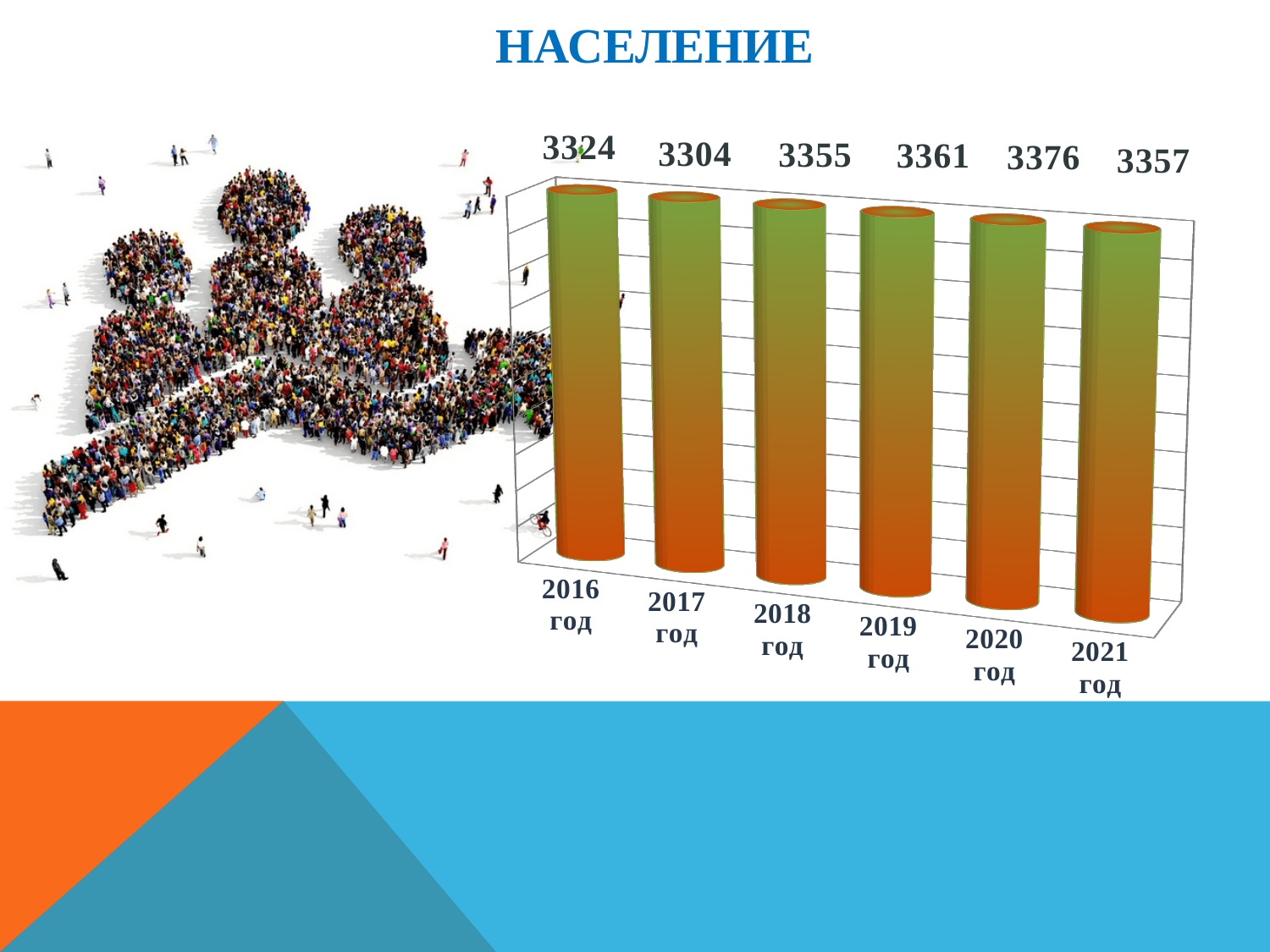
What is the difference between the population values for 2018 год and 2017 год? 51 What is the population value shown for 2021 год? 3357 What is the population value shown for 2019 год? 3361 How many years are shown on the chart? 6 Which year has a larger population value, 2019 год or 2018 год? 2019 год Which year has the highest population value on the chart? 2020 год Which year has the lowest population value on the chart? 2017 год What is the difference between the population values for 2020 год and 2016 год? 52 What is the population value shown for 2017 год? 3304 What is the title of the slide above the chart? НАСЕЛЕНИЕ What is the population value shown for 2016 год? 3324 What kind of chart is shown on the slide? Bar chart